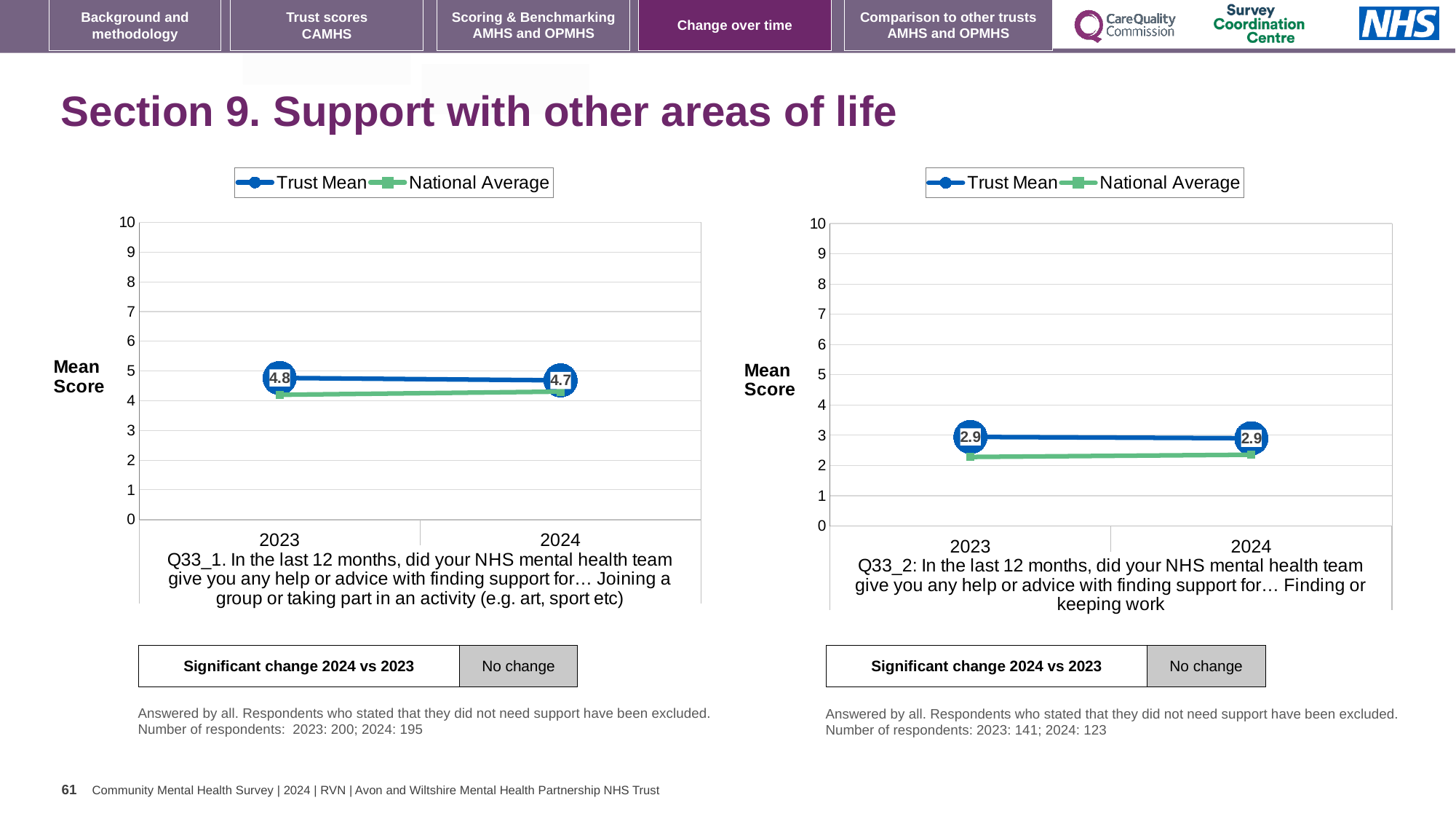
In the left chart (Q33_1), does the Trust Mean rise or fall from 2023 to 2024? Fall What does the 'Significant change 2024 vs 2023' box below the right chart (Q33_2) say? No change In the left chart (Q33_1), is the National Average for 2023 greater or less than 5? less In the right chart (Q33_2), what is the Trust Mean for 2024? 2.9 In the right chart (Q33_2), how many years are shown on the x axis? 2 In the left chart (Q33_1), what is the difference between the Trust Mean in 2023 and in 2024? 0.1 What kind of chart is the right chart (Q33_2)? Line chart In the left chart (Q33_1), what is the Trust Mean for 2024? 4.7 In the left chart (Q33_1), which year has the higher Trust Mean, 2023 or 2024? 2023 How many series does the legend of the left chart (Q33_1) list? 2 In the left chart (Q33_1), what is the Trust Mean for 2023? 4.8 In the right chart (Q33_2), is the National Average for 2024 greater or less than 3? less